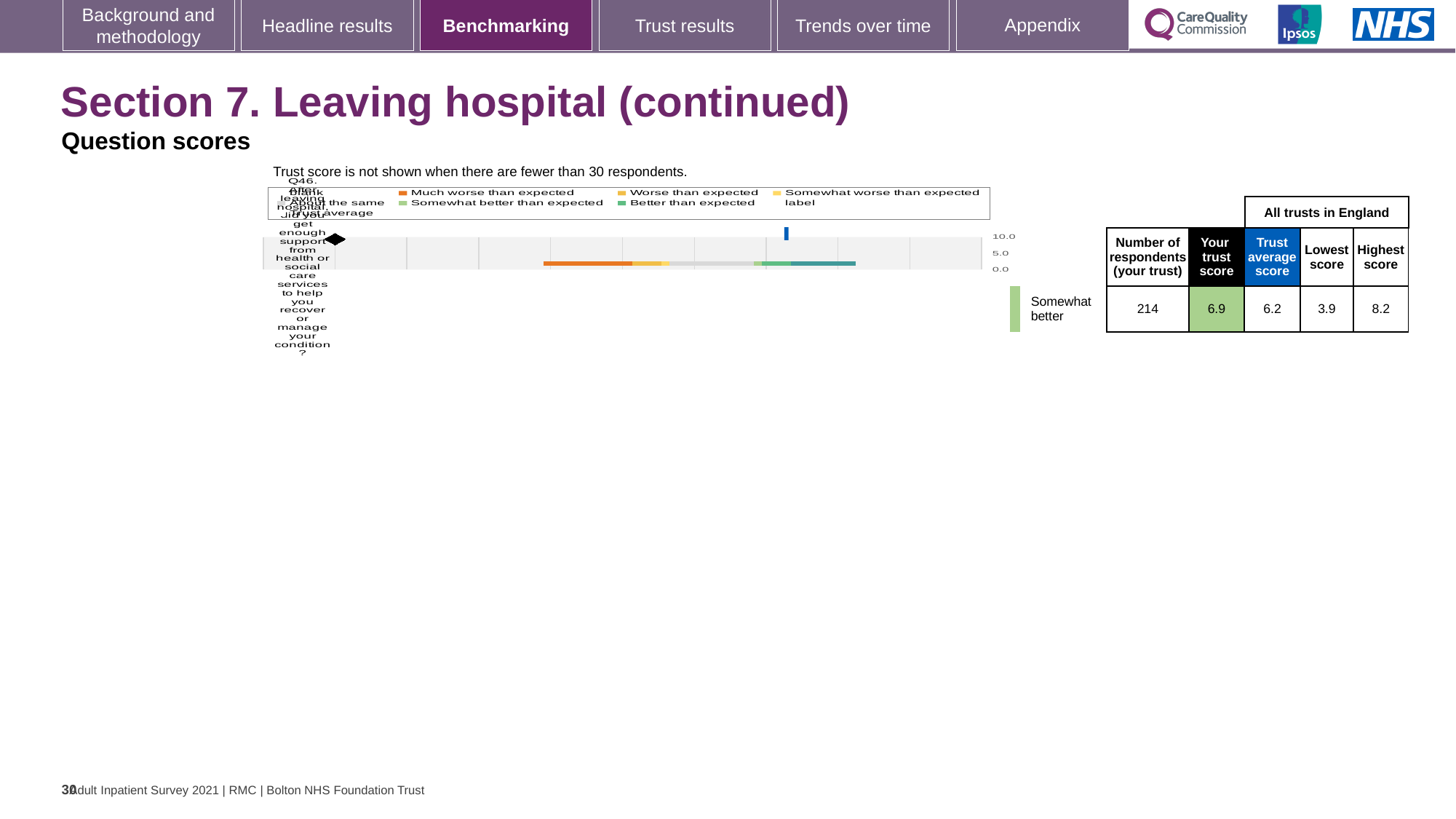
What is the highest score across all trusts in England for Q46? 8.2 How many respondents from the trust answered Q46? 214 Is the trust score for Q46 greater or less than 5.0? greater What kind of chart is shown on the slide? bar chart What is the difference between the trust score and the trust average score for Q46? 0.7 Which is larger for Q46, the trust score or the trust average score? trust score What is the lowest score across all trusts in England for Q46? 3.9 What is the highest value shown on the chart's axis? 10.0 What is the trust score for Q46 shown in the table next to the chart? 6.9 What is the trust average score for Q46 shown in the table next to the chart? 6.2 Which question number is plotted in the chart? Q46 How many questions (categories) are plotted in the chart? 1